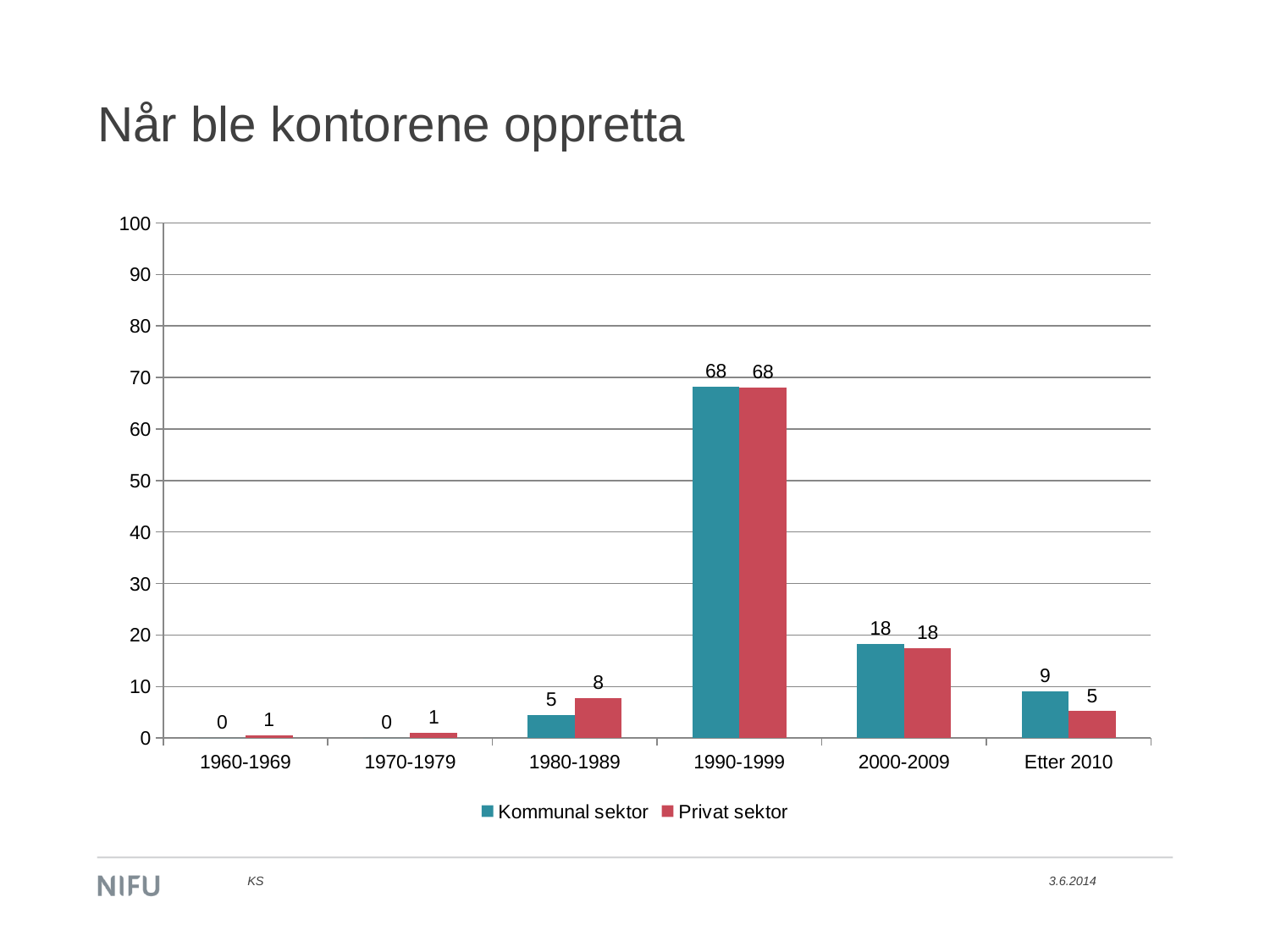
Which is larger in 1980-1989, Kommunal sektor or Privat sektor? Privat sektor What is the value for Privat sektor in 1980-1989? 8 What is the value for Kommunal sektor in 1990-1999? 68 How many series does the legend list? 2 What is the value for Kommunal sektor in Etter 2010? 9 How many periods are shown on the x axis? 6 What is the title of the slide? Når ble kontorene oppretta What is the difference between Kommunal sektor and Privat sektor in Etter 2010? 4 What is the value for Privat sektor in 1960-1969? 1 What is the difference between Kommunal sektor in 1990-1999 and Kommunal sektor in 2000-2009? 50 Which period has the highest value for Kommunal sektor? 1990-1999 What kind of chart is shown on the slide? Bar chart